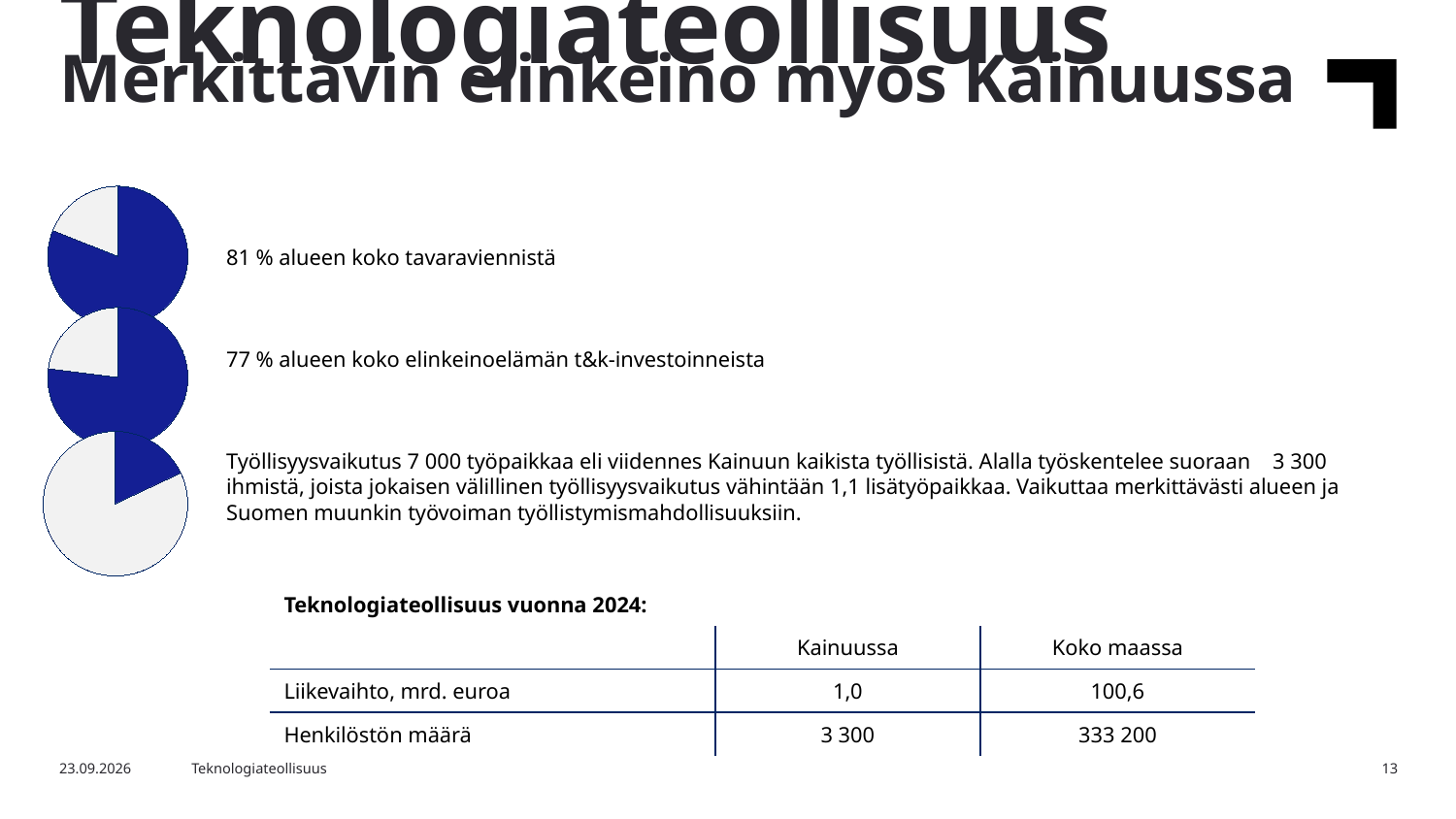
Do the pie charts on the slide have a legend? No What is the difference in percentage points between the share shown for the top pie chart (81 %) and the middle pie chart (77 %)? 4 According to the text next to the middle pie chart, what share of the region's business R&D investments (t&k-investoinnit) does the technology industry account for? 77 % What colour is the larger slice in the top pie chart? Blue How many slices does each pie chart on the slide have? 2 Which pie chart has the larger blue slice, the top one or the bottom one? The top one Which of the three pie charts has the smallest blue slice? The bottom one In the bottom pie chart, is the blue slice larger or smaller than the grey slice? Smaller Which of the three pie charts has the largest blue slice? The top one What kind of charts are shown on the left side of the slide? Pie charts According to the text next to the top pie chart, what share of the region's total goods exports (tavaravienti) does the technology industry account for? 81 % How many pie charts are on the slide? 3